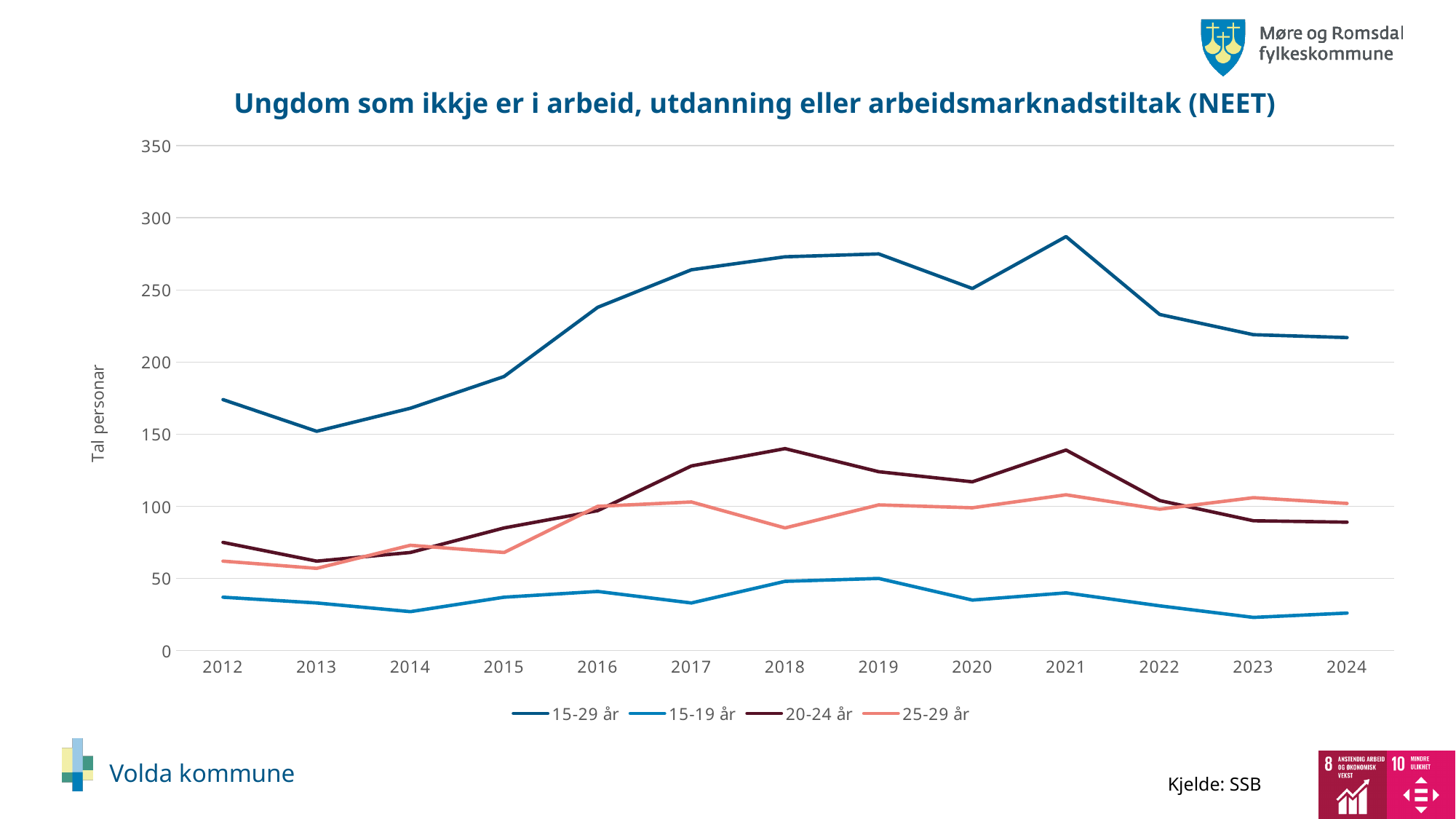
In which year does the 20-24 år series reach its lowest value? 2013 What kind of chart is shown on the slide? line chart Is the value for 20-24 år in 2018 greater or less than 100? greater How many years are shown along the x axis? 13 What is the label on the y axis? Tal personar Which series has the larger value in 2018, 20-24 år or 25-29 år? 20-24 år In which year does the 15-29 år series reach its highest value? 2021 Is the value for 15-29 år in 2021 greater or less than 250? greater In which year does the 15-29 år series reach its lowest value? 2013 Does the 15-29 år series rise or fall from 2021 to 2024? fall How many series does the legend list? 4 Is the value for 15-19 år in 2014 greater or less than 50? less